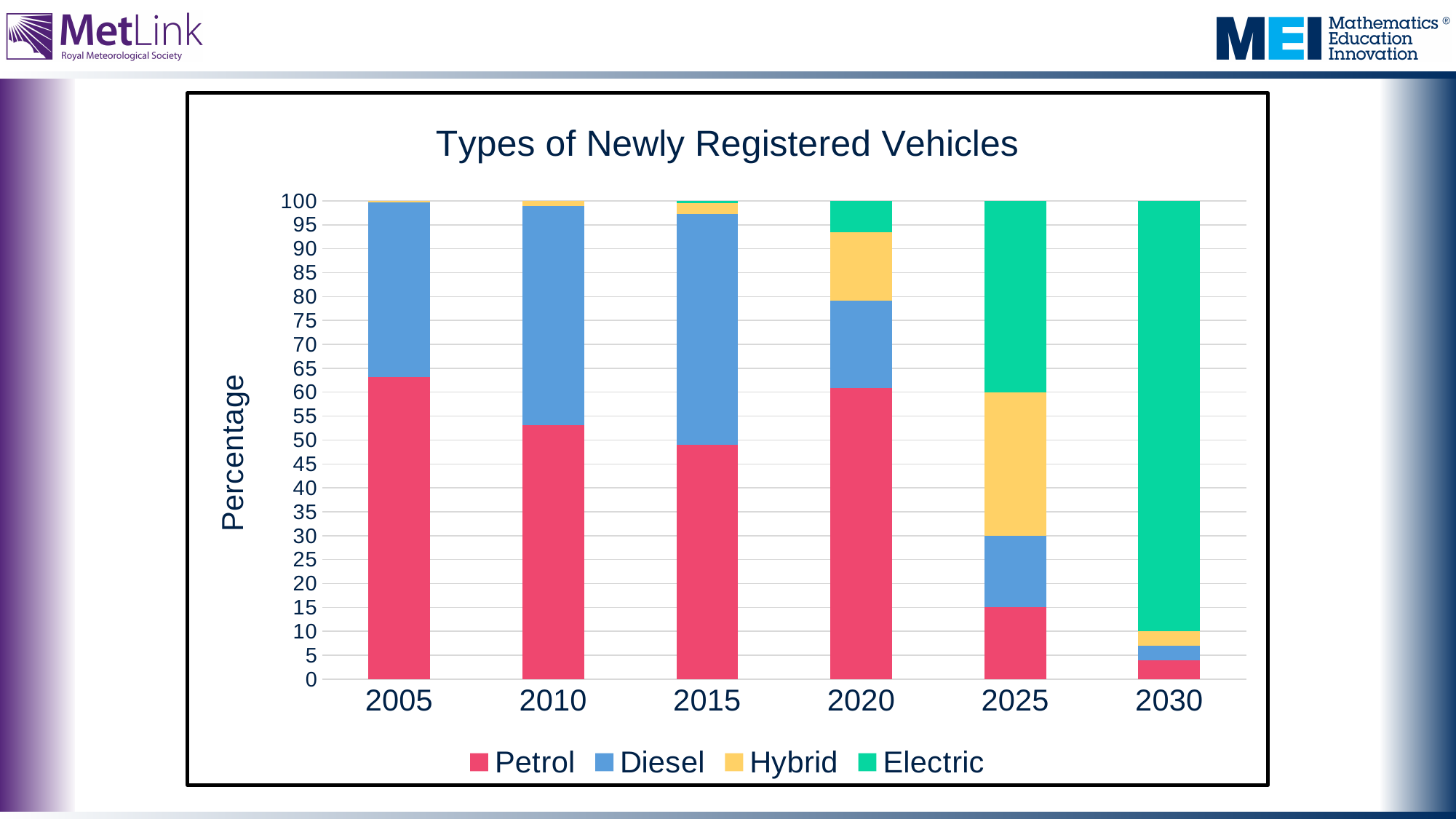
Which year has the smallest Petrol share? 2030 Is the Petrol percentage for 2010 greater or less than 50? greater What is the label on the vertical axis? Percentage Which year has the largest Electric share? 2030 How many years are shown on the x axis of the chart? 6 How many series does the legend list? 4 Which is larger, the Petrol share in 2005 or the Petrol share in 2030? 2005 Is the Petrol percentage for 2005 greater or less than 60? greater Is the Electric percentage for 2030 greater or less than 85? greater What kind of chart is shown on the slide? Stacked bar chart What is the title of the chart? Types of Newly Registered Vehicles